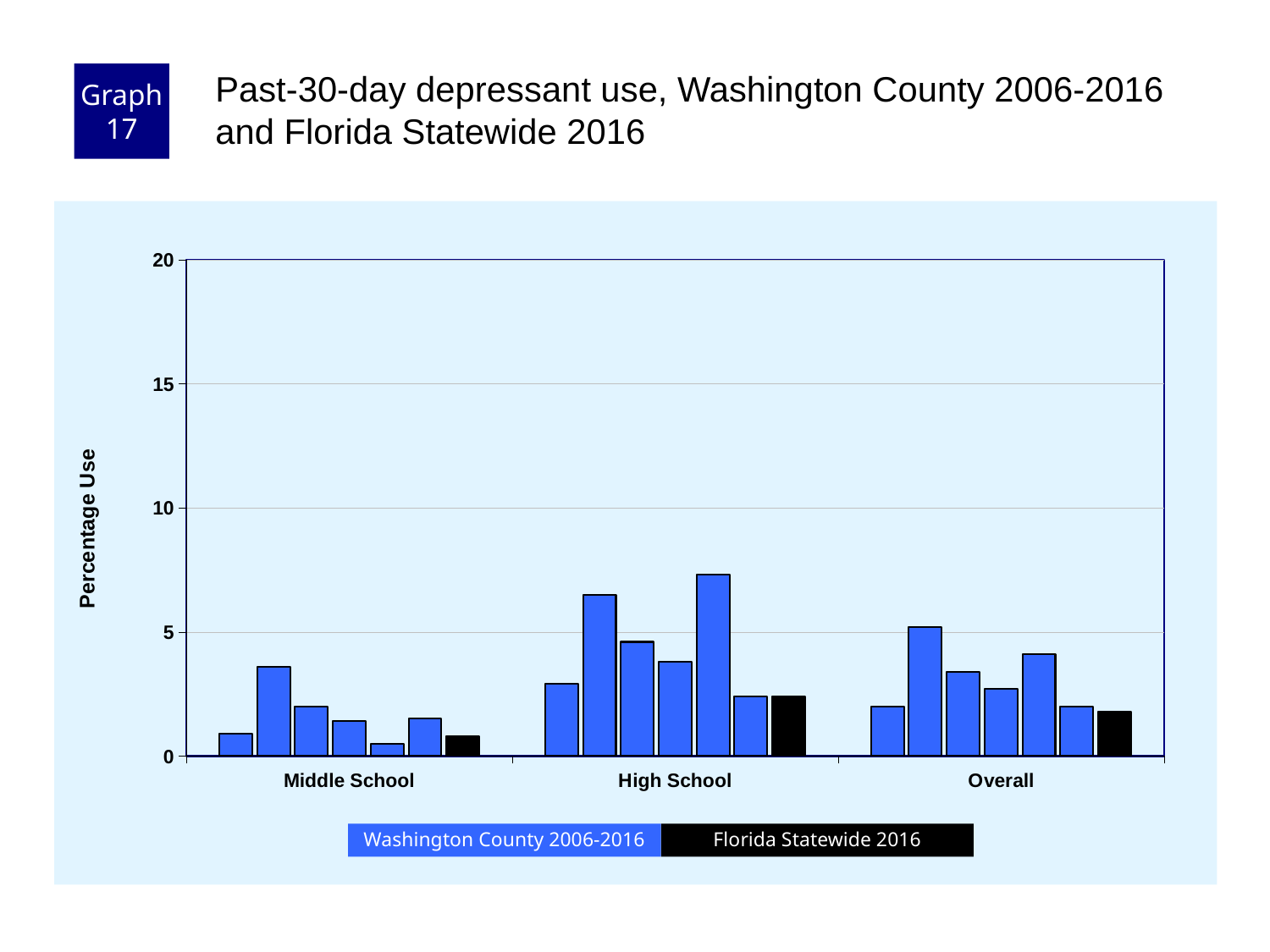
Are all the Middle School bars greater or less than 5? less Is the tallest Washington County 2006-2016 bar for High School greater or less than 5? greater What kind of chart is shown on the slide? bar chart Which colour represents Florida Statewide 2016 in the legend? black How many categories are shown along the x axis? 3 How many series does the legend list? 2 What is the label on the y axis? Percentage Use Is the Florida Statewide 2016 value for High School greater or less than 5? less Which category contains the tallest bar in the chart? High School Which is larger, the Florida Statewide 2016 value for High School or for Middle School? High School Which category has the lowest bars overall? Middle School